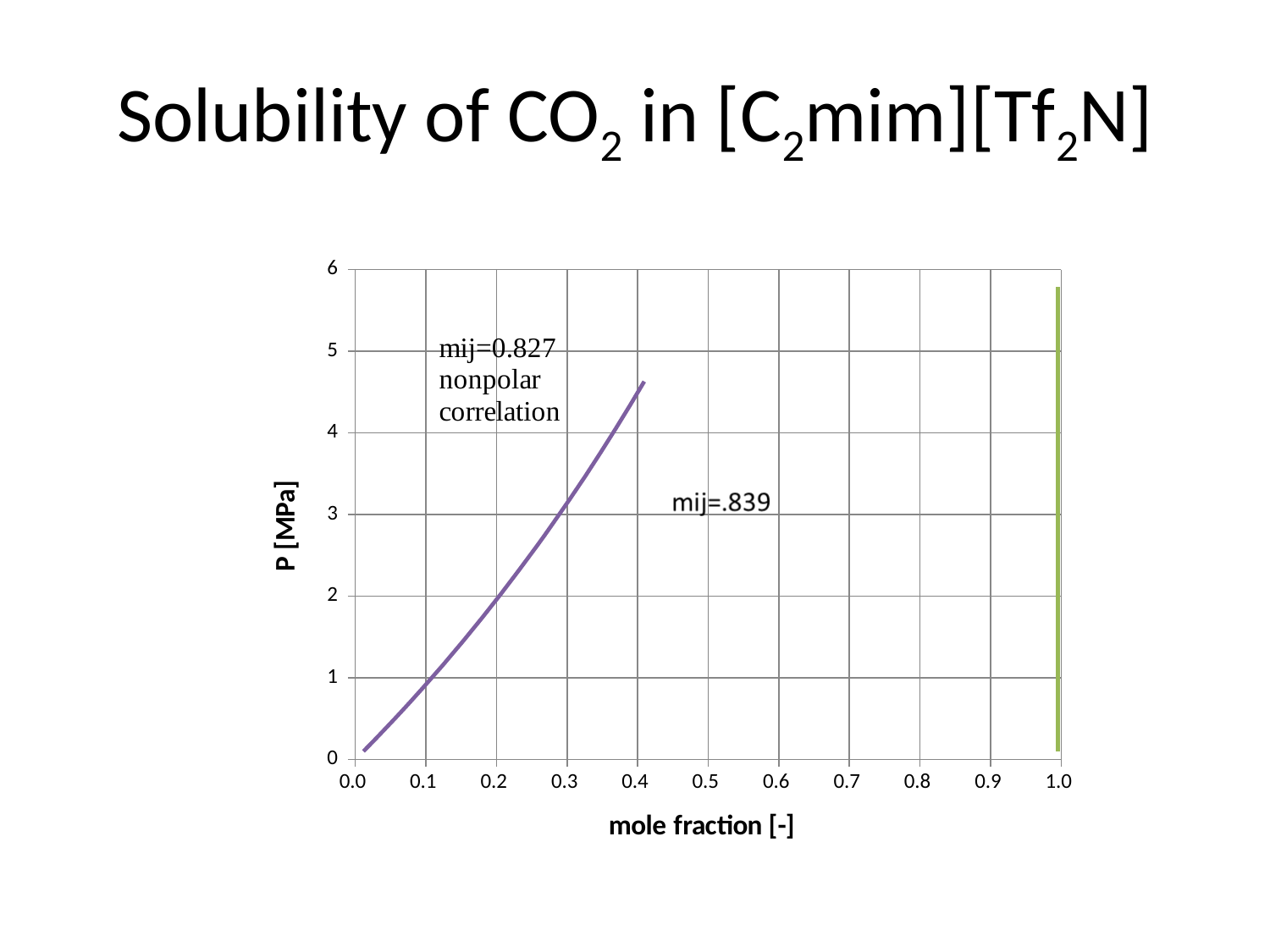
Is the pressure on the purple curve at a mole fraction of 0.3 greater or less than 2 MPa? greater Is the highest pressure reached by the purple curve greater or less than 5 MPa? less Is the top of the green vertical line at mole fraction 1.0 greater or less than 5 MPa? greater What kind of chart is shown on the slide? line chart What mij value is given in the annotation labelled 'nonpolar correlation'? 0.827 Does the purple curve rise or fall as mole fraction increases? rise What is the label of the x axis? mole fraction [-] How many lines are plotted on the chart? 2 What is the label of the y axis? P [MPa]